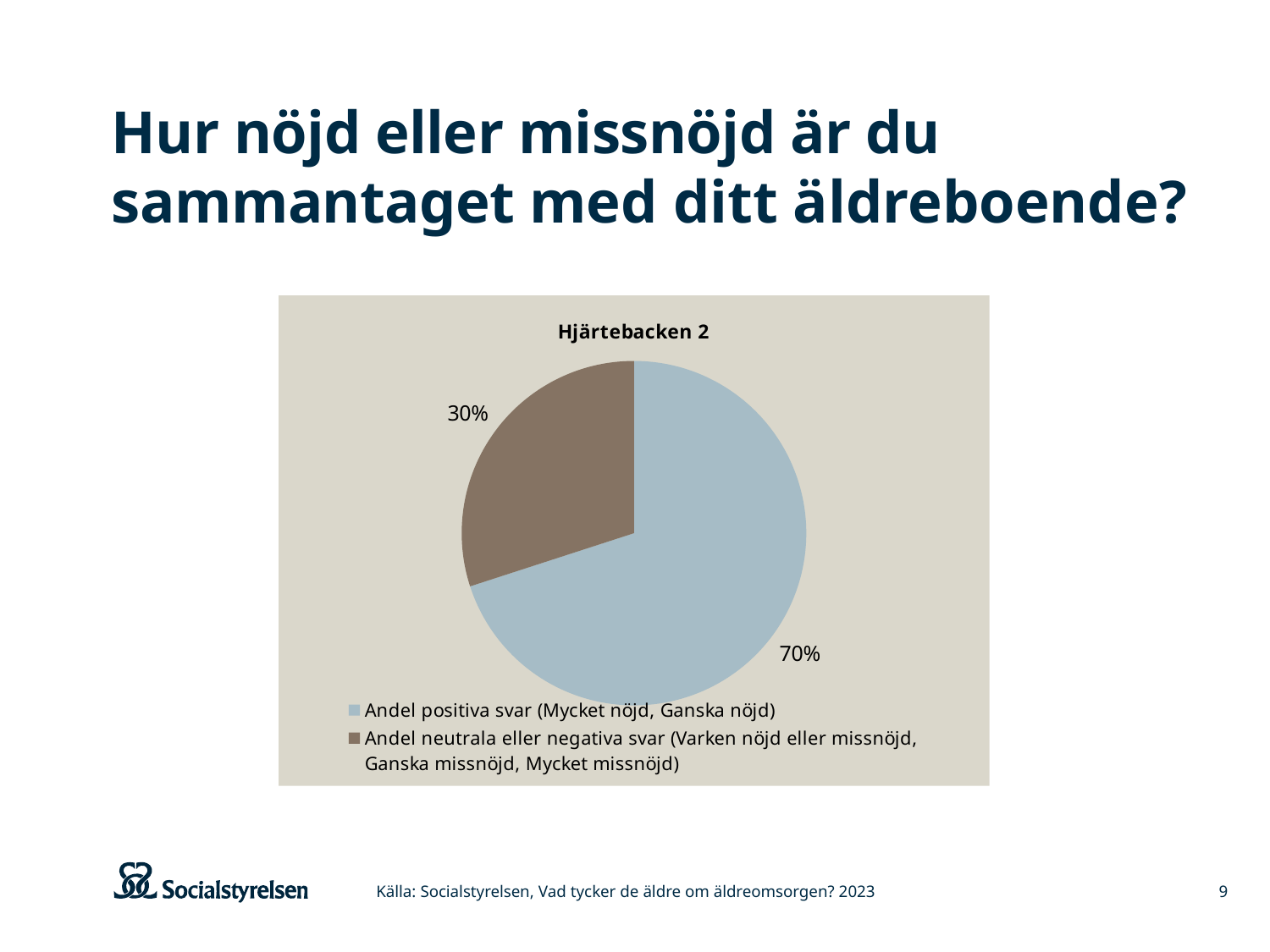
Which is larger: the share of positive answers or the share of neutral or negative answers? Andel positiva svar (Mycket nöjd, Ganska nöjd) How many slices does the pie chart have? 2 What kind of chart is shown on the slide? pie chart What share of the pie is 'Andel neutrala eller negativa svar (Varken nöjd eller missnöjd, Ganska missnöjd, Mycket missnöjd)'? 30% Which slice of the pie is the smallest? Andel neutrala eller negativa svar (Varken nöjd eller missnöjd, Ganska missnöjd, Mycket missnöjd) What is the difference in percentage points between the positive-answer slice and the neutral-or-negative slice? 40 percentage points What is the total of the two slices shown in the pie chart? 100% What colour is the slice for 'Andel positiva svar (Mycket nöjd, Ganska nöjd)'? light blue How many entries does the legend list? 2 What is the title of the chart? Hjärtebacken 2 Which slice of the pie is the largest? Andel positiva svar (Mycket nöjd, Ganska nöjd) What share of the pie is 'Andel positiva svar (Mycket nöjd, Ganska nöjd)'? 70%